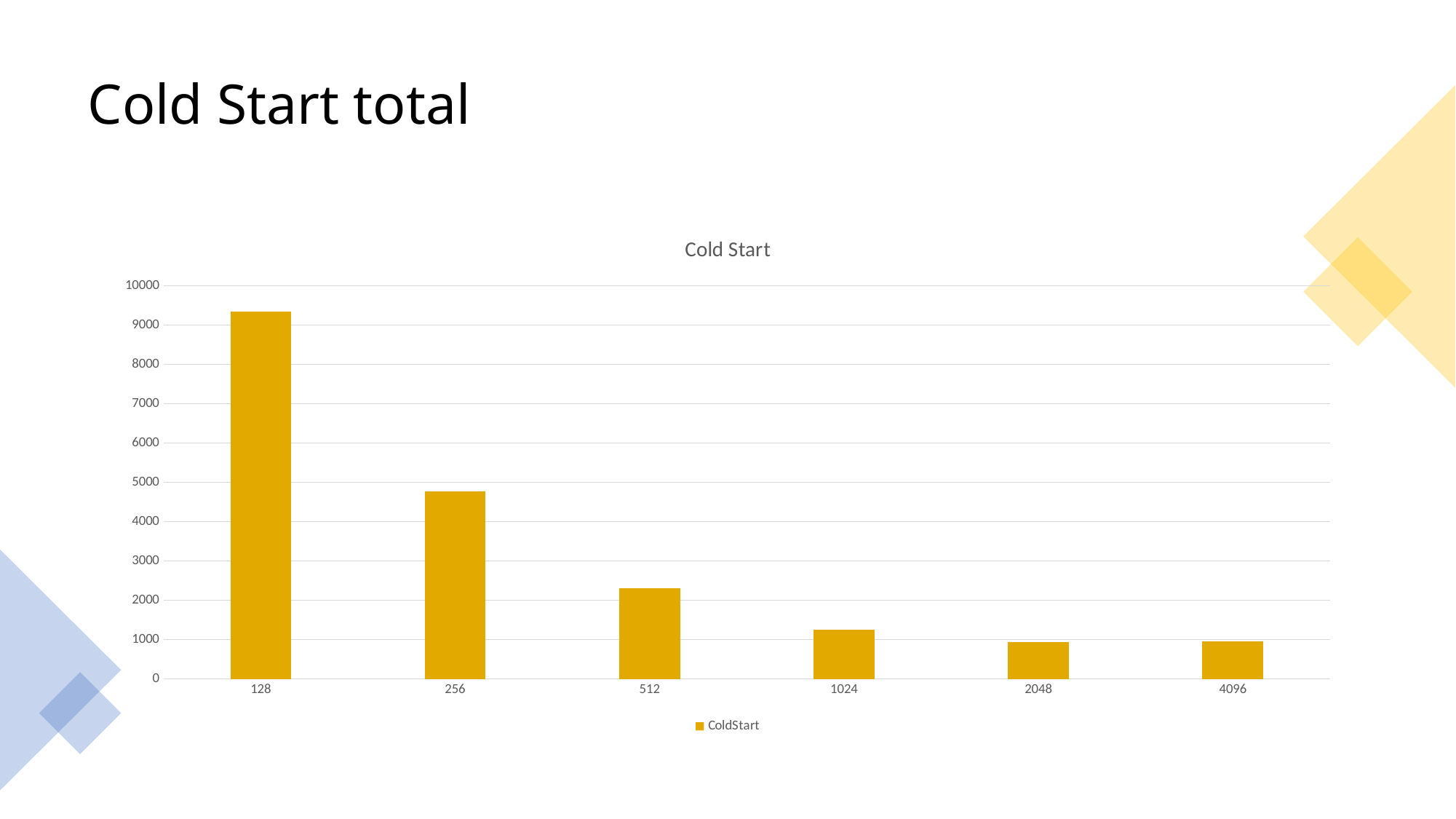
Is the ColdStart value for 512 greater or less than 2000? greater Which has a larger ColdStart value, 256 or 512? 256 How many series does the legend of the Cold Start chart list? 1 Which category has the highest ColdStart value? 128 What is the title of the chart? Cold Start Is the ColdStart value for 128 greater or less than 9000? greater How many categories are shown on the x axis of the Cold Start chart? 6 What kind of chart is shown on the slide? bar chart Is the ColdStart value for 2048 greater or less than 1000? less Do the ColdStart values generally rise or fall as the categories increase from 128 to 4096? fall